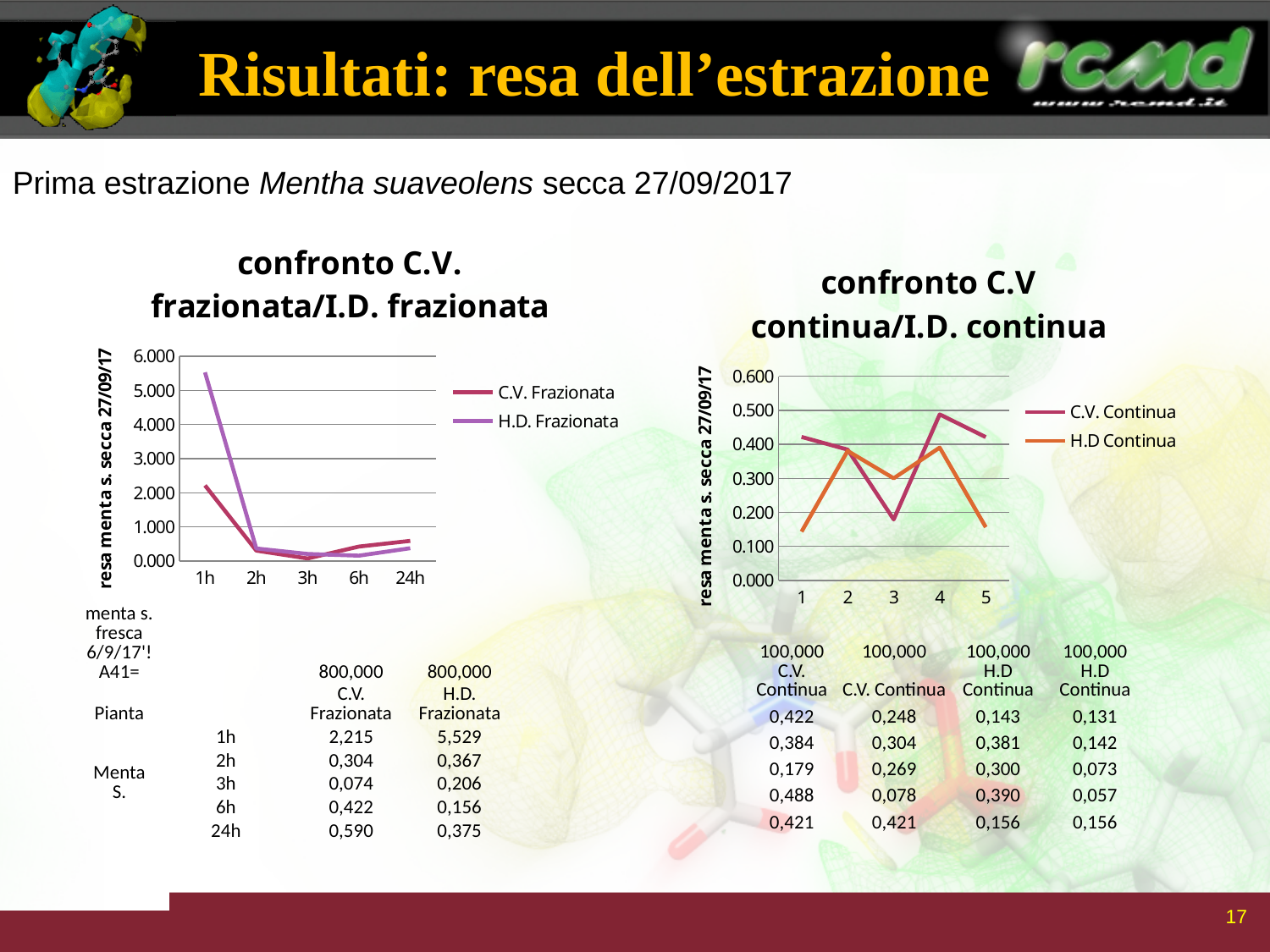
In the left chart "confronto C.V. frazionata/I.D. frazionata", which series has the larger value at 1h, C.V. Frazionata or H.D. Frazionata? H.D. Frazionata In the right chart "confronto C.V continua/I.D. continua", at which x-axis point does C.V. Continua reach its highest value? 4 In the right chart "confronto C.V continua/I.D. continua", is the value for H.D Continua at point 1 greater or less than 0.200? less What kind of chart is the left chart titled "confronto C.V. frazionata/I.D. frazionata"? line chart In the left chart "confronto C.V. frazionata/I.D. frazionata", is the value for H.D. Frazionata at 1h greater or less than 5.000? greater In the left chart "confronto C.V. frazionata/I.D. frazionata", is the value for C.V. Frazionata at 1h greater or less than 3.000? less In the right chart "confronto C.V continua/I.D. continua", which series has the larger value at point 3, C.V. Continua or H.D Continua? H.D Continua How many series does the legend of the right chart "confronto C.V continua/I.D. continua" list? 2 In the left chart "confronto C.V. frazionata/I.D. frazionata", which time point has the lowest value for C.V. Frazionata? 3h In the left chart "confronto C.V. frazionata/I.D. frazionata", which time point has the highest value for H.D. Frazionata? 1h How many time points are shown on the x axis of the left chart "confronto C.V. frazionata/I.D. frazionata"? 5 In the right chart "confronto C.V continua/I.D. continua", at which x-axis point does C.V. Continua reach its lowest value? 3